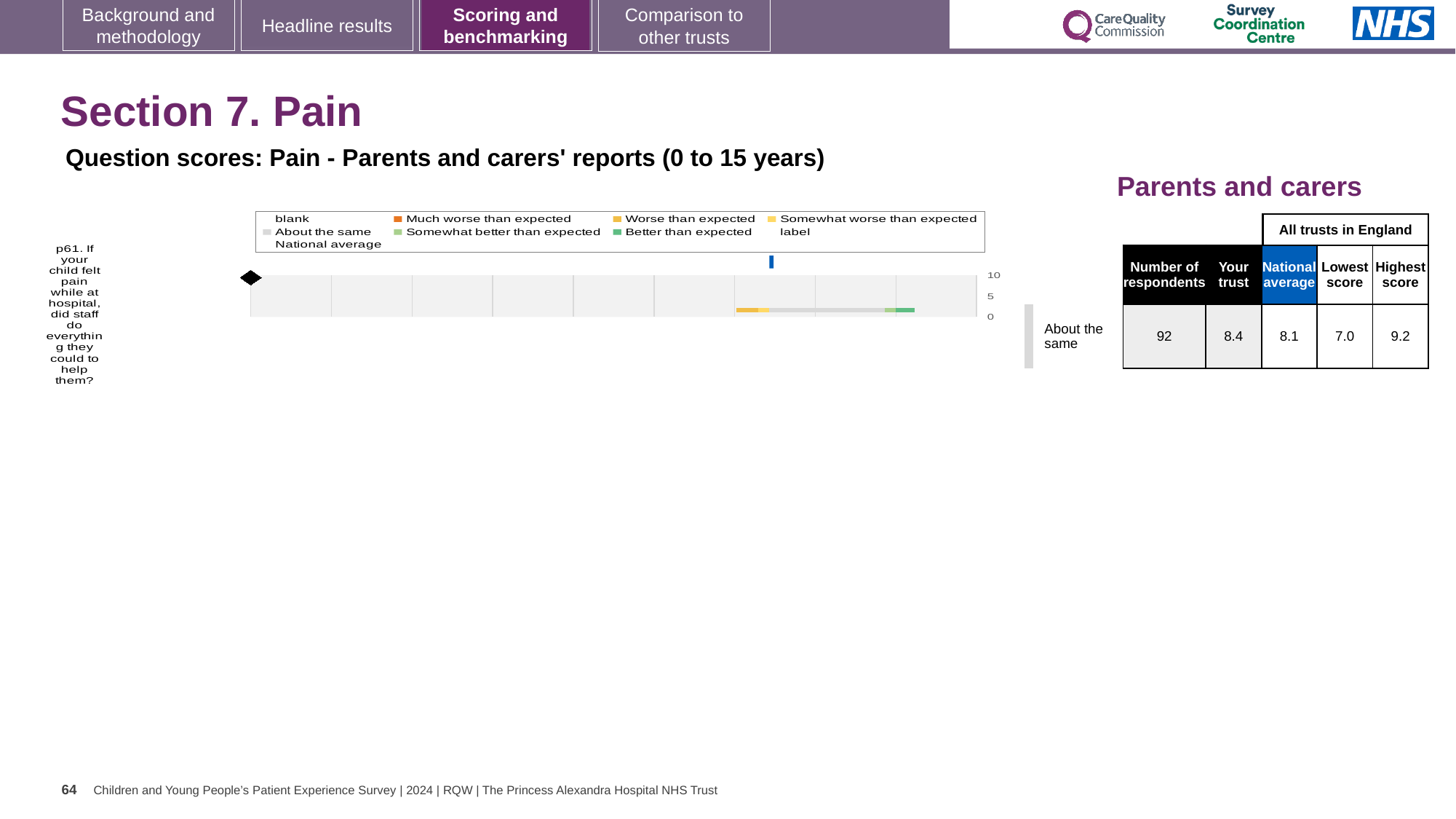
What is the number of respondents for question p61 shown in the table beside the chart? 92 What is the difference between the highest and lowest scores among all trusts in England for question p61? 2.2 What is the highest value shown on the chart's score axis? 10 What is the national average score for question p61 shown in the table beside the chart? 8.1 What is the lowest score among all trusts in England for question p61? 7.0 What is the difference between the 'Your trust' score and the national average for question p61? 0.3 What is the 'Your trust' score for question p61 shown in the table beside the chart? 8.4 Which is larger for question p61: the 'Your trust' score or the national average? Your trust What is the highest score among all trusts in England for question p61? 9.2 What kind of chart is shown on the slide for question p61? bar chart How many survey questions are plotted in the chart? 1 According to the legend, what colour represents 'Better than expected'? green